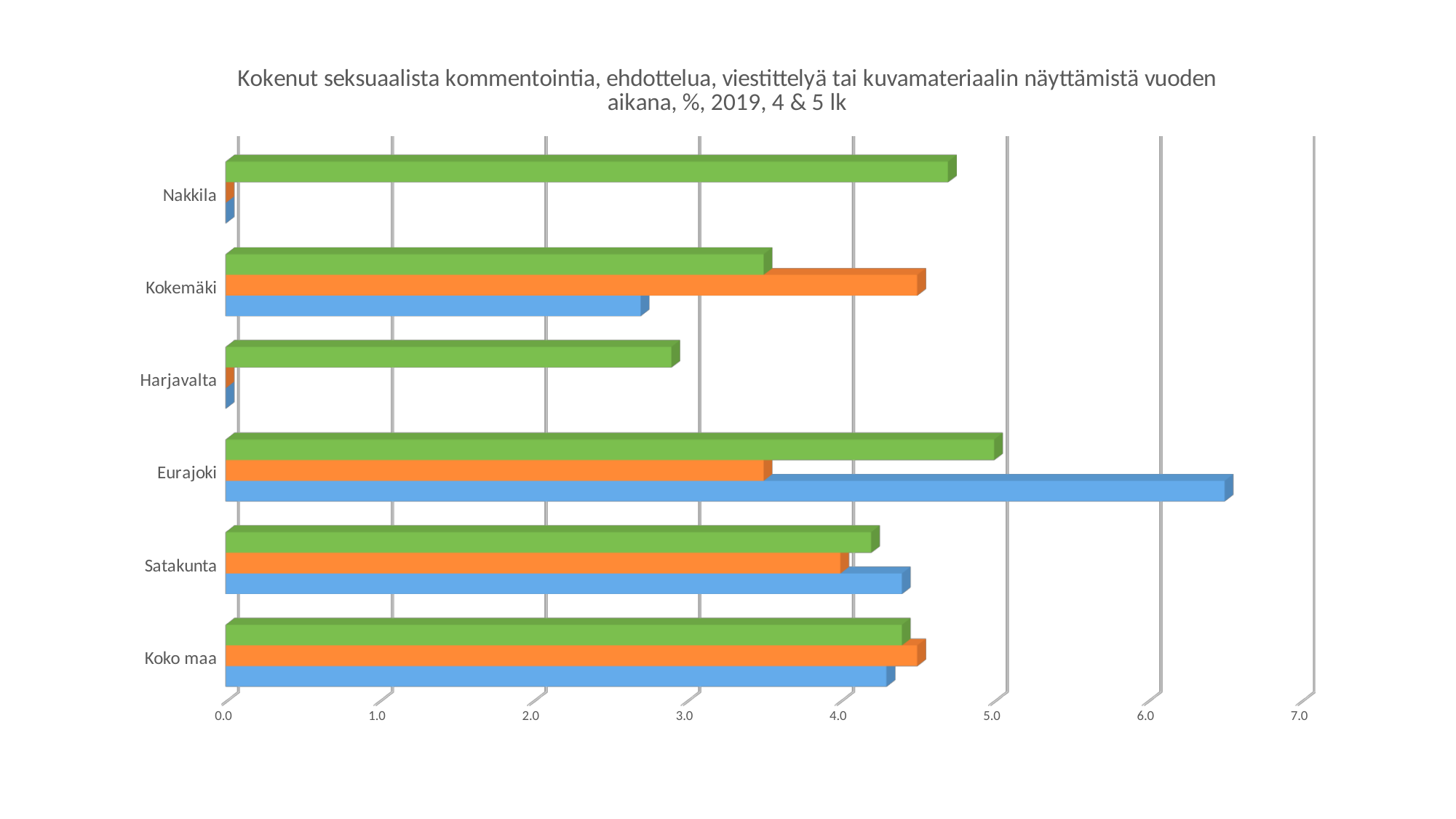
Is the value of the green bar for Harjavalta greater or less than 3.0? less What is the highest value shown on the horizontal axis of the chart? 7.0 Is the value of the green bar for Nakkila greater or less than 4.0? greater Which is larger, the blue bar for Eurajoki or the blue bar for Satakunta? Eurajoki What kind of chart is shown on the slide? bar chart Which category has the longest bar in the chart? Eurajoki Is the value of the blue bar for Kokemäki greater or less than 3.0? less How many categories are shown on the vertical axis of the chart? 6 How many bars are plotted for the Eurajoki category? 3 Which is larger, the green bar for Nakkila or the green bar for Harjavalta? Nakkila